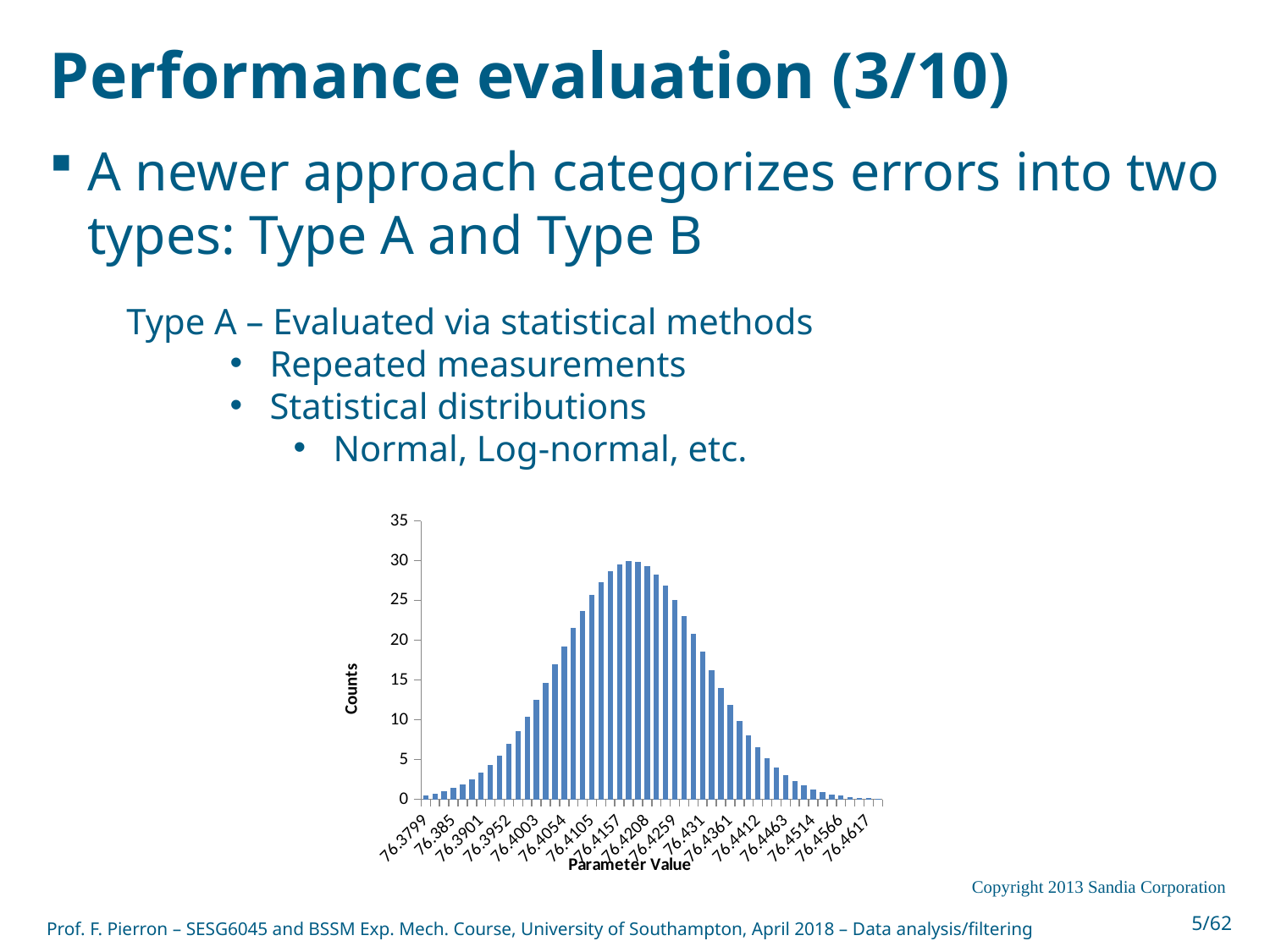
Which has the larger value, 76.4105 or 76.4514? 76.4105 Do the values rise or fall along the x axis from 76.4208 to 76.4617? fall Do the values rise or fall along the x axis from 76.3799 to 76.4208? rise What is the title of the vertical axis of the chart? Counts Is the value for 76.4617 greater or less than 5? less Is the value for 76.3799 greater or less than 5? less What kind of chart is shown on the slide? bar chart Is the value for 76.4208 greater or less than 25? greater What is the title of the horizontal axis of the chart? Parameter Value Which has the larger value, 76.4208 or 76.3799? 76.4208